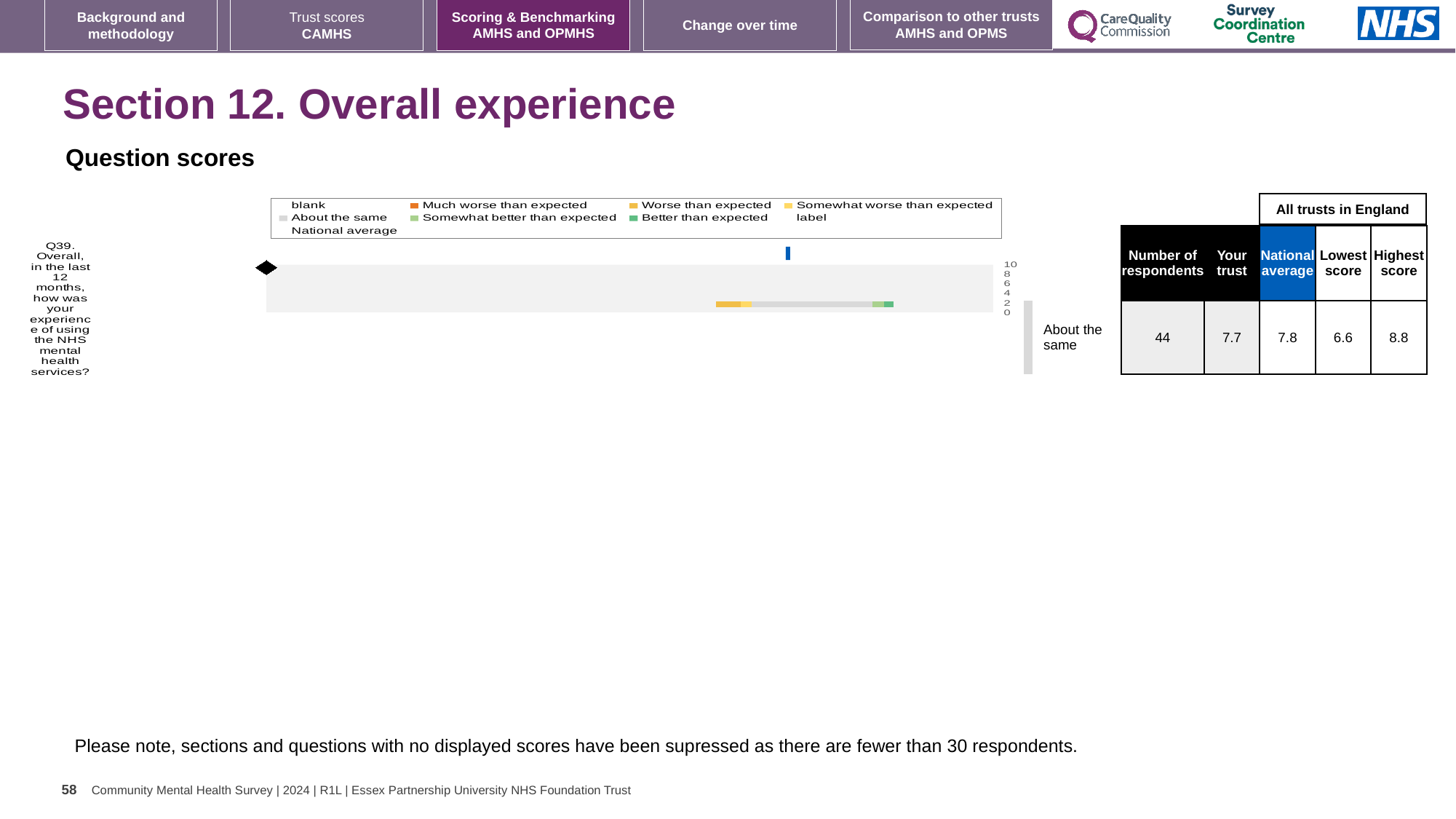
What is the national average score for Q39? 7.8 By how much does the national average exceed the 'Your trust' score for Q39? 0.1 How many questions are plotted in the chart? 1 Which benchmark category is Q39 placed in? About the same How many respondents answered Q39? 44 What is the 'Your trust' score for Q39 (overall experience of using NHS mental health services)? 7.7 Which is larger for Q39, the 'Your trust' score or the national average? National average What kind of chart is shown on the slide? bar chart What is the lowest score among all trusts in England for Q39? 6.6 What is the difference between the highest score and the lowest score for Q39? 2.2 What is the highest score among all trusts in England for Q39? 8.8